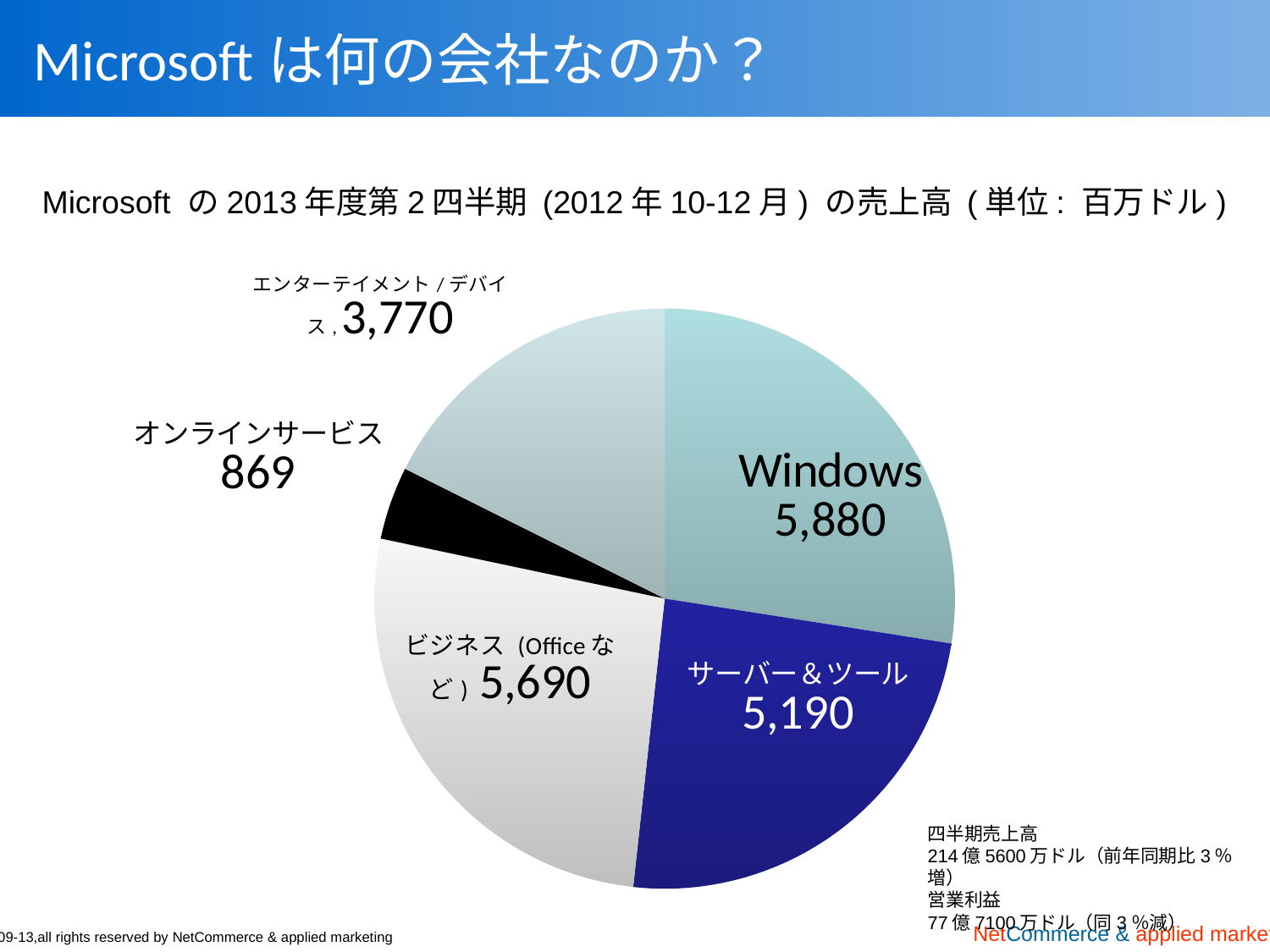
What is the value for ビジネス (Officeなど)? 5,690 How many segments does the pie chart have? 5 What is the value for Windows? 5,880 What colour is the サーバー＆ツール slice? dark blue Which is larger, the value for Windows or the value for ビジネス (Officeなど)? Windows What type of chart is shown on the slide? pie chart What is the value for オンラインサービス? 869 What is the difference between the Windows value and the サーバー＆ツール value? 690 What is the value for サーバー＆ツール? 5,190 What is the value for エンターテイメント/デバイス? 3,770 Which segment has the highest value? Windows Which segment has the lowest value? オンラインサービス